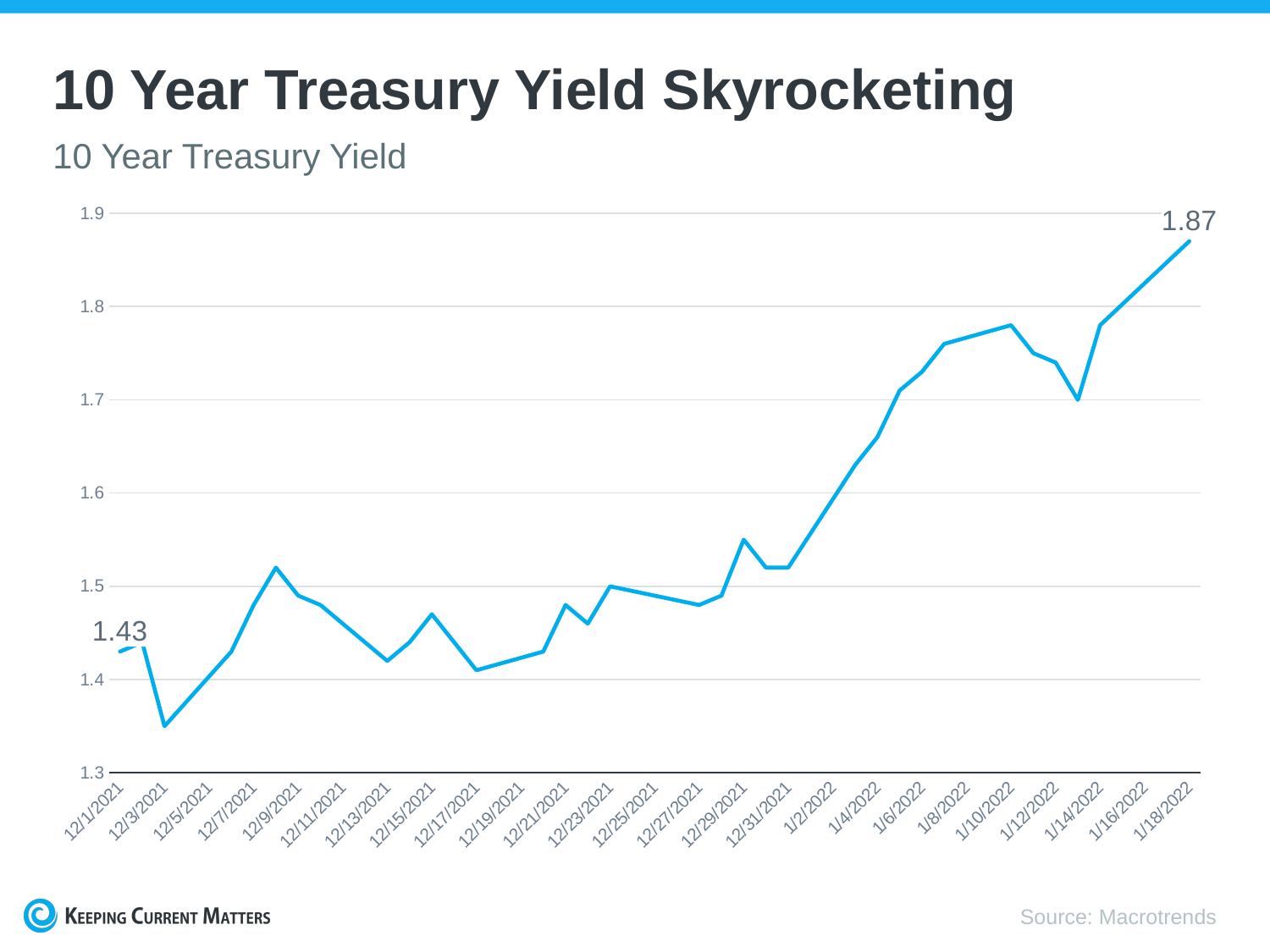
What is the 10 Year Treasury Yield value shown for 1/18/2022? 1.87 What kind of chart is used to show the 10 Year Treasury Yield? line chart Is the yield on 12/17/2021 greater or less than 1.5? less Is the yield on 1/8/2022 greater or less than 1.7? greater Which date has the higher yield, 12/1/2021 or 1/18/2022? 1/18/2022 What is the 10 Year Treasury Yield value shown for 12/1/2021? 1.43 On which date does the 10 Year Treasury Yield reach its lowest point? 12/3/2021 What source is cited for the chart data? Macrotrends On which date does the 10 Year Treasury Yield reach its highest point? 1/18/2022 Is the yield on 12/3/2021 greater or less than 1.4? less Does the 10 Year Treasury Yield generally rise or fall from 12/1/2021 to 1/18/2022? rise By how much did the 10 Year Treasury Yield rise from 12/1/2021 to 1/18/2022? 0.44